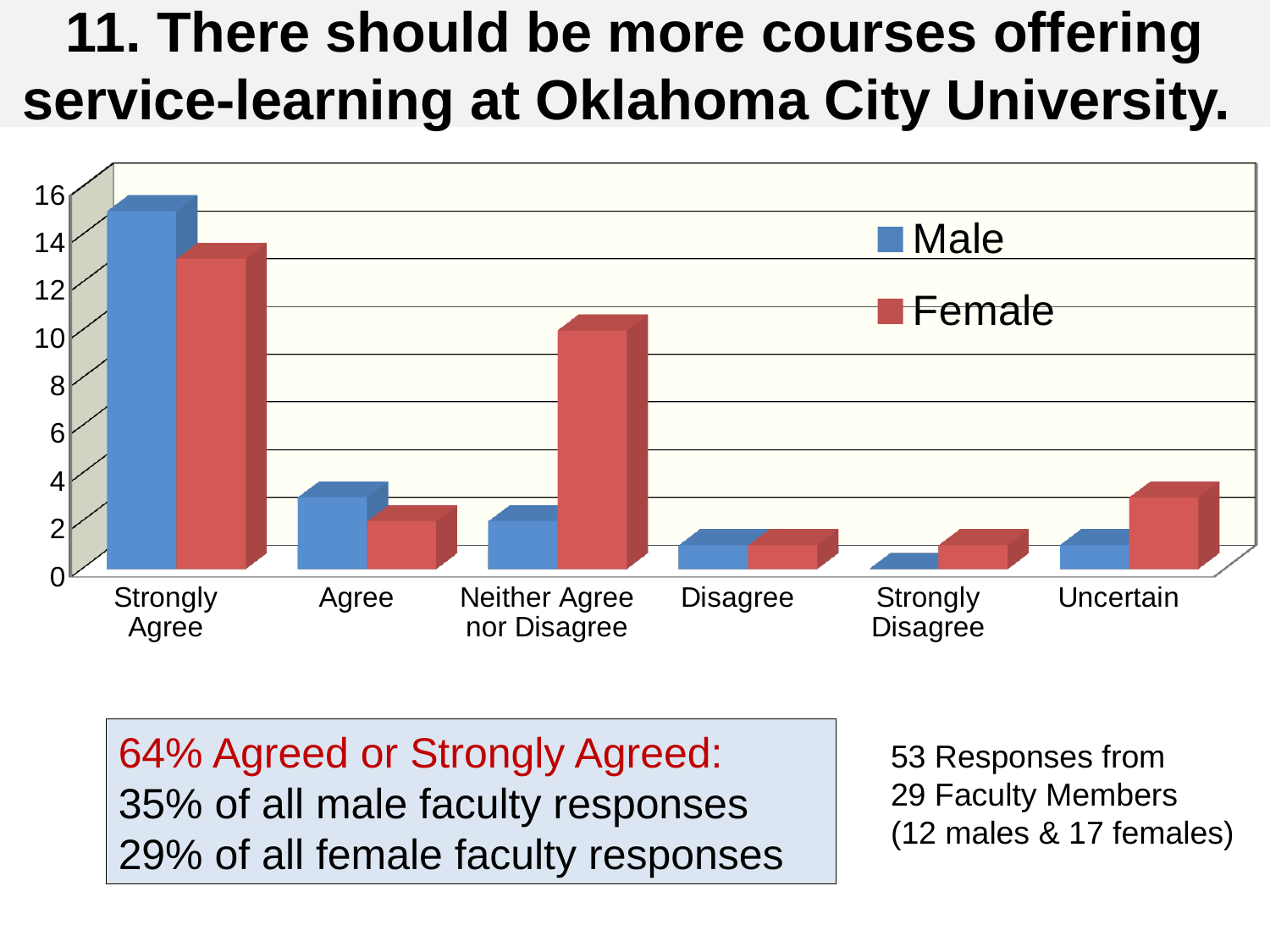
For Strongly Agree, is the Male or Female value larger? Male Which category has the lowest Male value? Strongly Disagree Which category has the highest Female value? Strongly Agree For Neither Agree nor Disagree, is the Male or Female value larger? Female Is the Female value for Neither Agree nor Disagree greater or less than 8? greater How many response categories are shown on the x axis? 6 For Uncertain, is the Male or Female value larger? Female How many series does the legend list? 2 Which category has the highest Male value? Strongly Agree Which colour represents the Female series in the legend? red Is the Male value for Strongly Agree greater or less than 14? greater What kind of chart is shown on the slide? bar chart